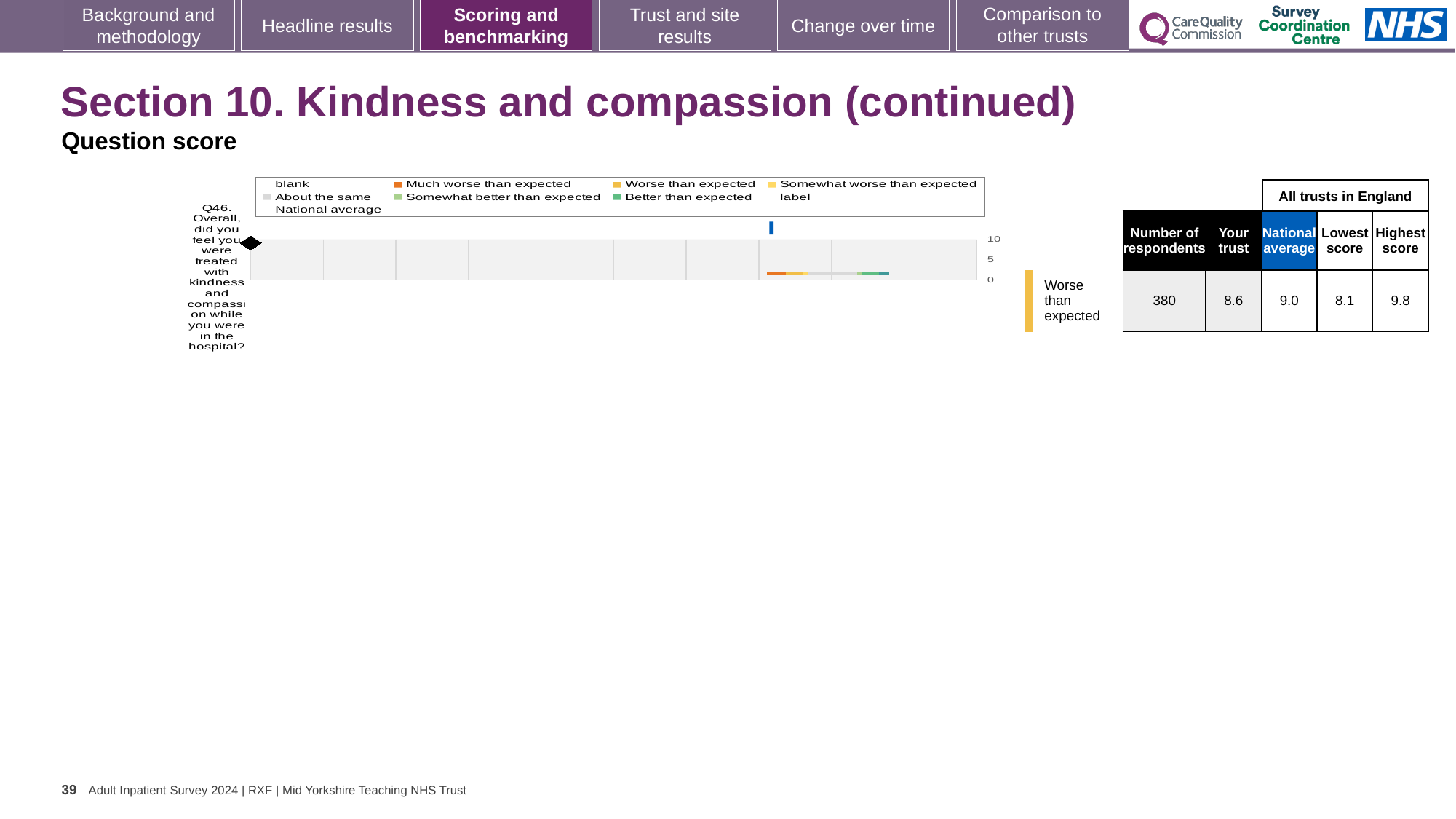
What is the National average score shown for Q46? 9.0 What is the Highest score among all trusts in England for Q46? 9.8 What is the score for Your trust on Q46? 8.6 What kind of chart is used to show the Q46 question score? bar chart What is the Lowest score among all trusts in England for Q46? 8.1 Which is larger for Q46, Your trust score or the National average? National average What is the difference between the Highest score and the Lowest score for Q46? 1.7 By how much is the National average higher than Your trust score for Q46? 0.4 Which benchmarking category does the trust's Q46 score fall into? Worse than expected Is the trust's score for Q46 greater or less than 5? greater Which survey question is plotted on the chart? Q46 How many respondents are shown for Q46? 380